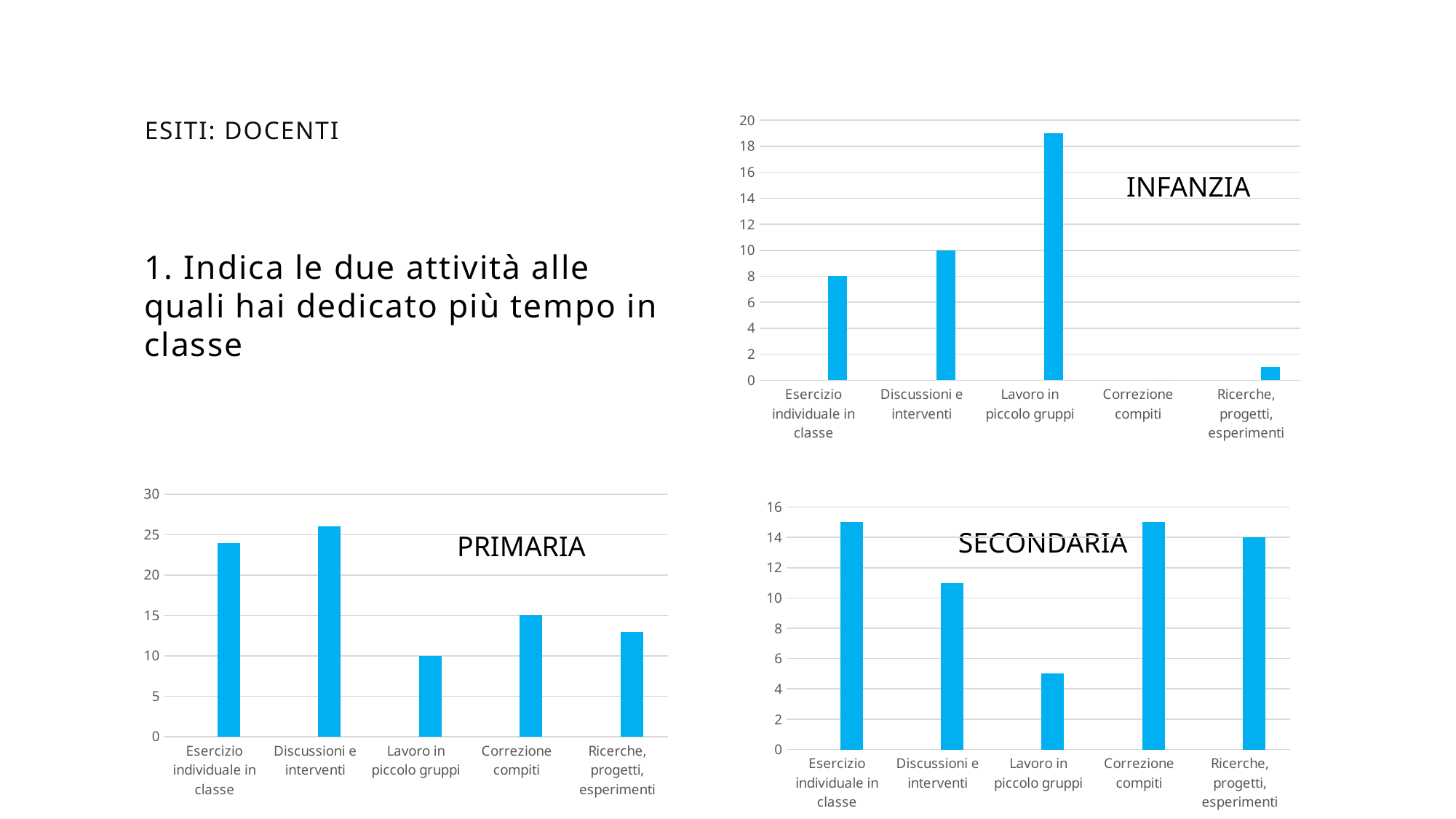
In the INFANZIA chart, what is the value for Discussioni e interventi? 10 In the SECONDARIA chart, what is the value for Ricerche, progetti, esperimenti? 14 In the INFANZIA chart, which category has the highest value? Lavoro in piccolo gruppi In the PRIMARIA chart, what is the value for Lavoro in piccolo gruppi? 10 In the PRIMARIA chart, what is the difference between Correzione compiti and Lavoro in piccolo gruppi? 5 In the INFANZIA chart, what is the value for Esercizio individuale in classe? 8 In the SECONDARIA chart, is the value for Lavoro in piccolo gruppi greater or less than 6? less In the INFANZIA chart, is the value for Lavoro in piccolo gruppi greater or less than 18? greater In the PRIMARIA chart, what is the value for Correzione compiti? 15 In the PRIMARIA chart, which category has the lowest value? Lavoro in piccolo gruppi In the SECONDARIA chart, which category has the lowest value? Lavoro in piccolo gruppi How many categories are shown in the PRIMARIA chart? 5